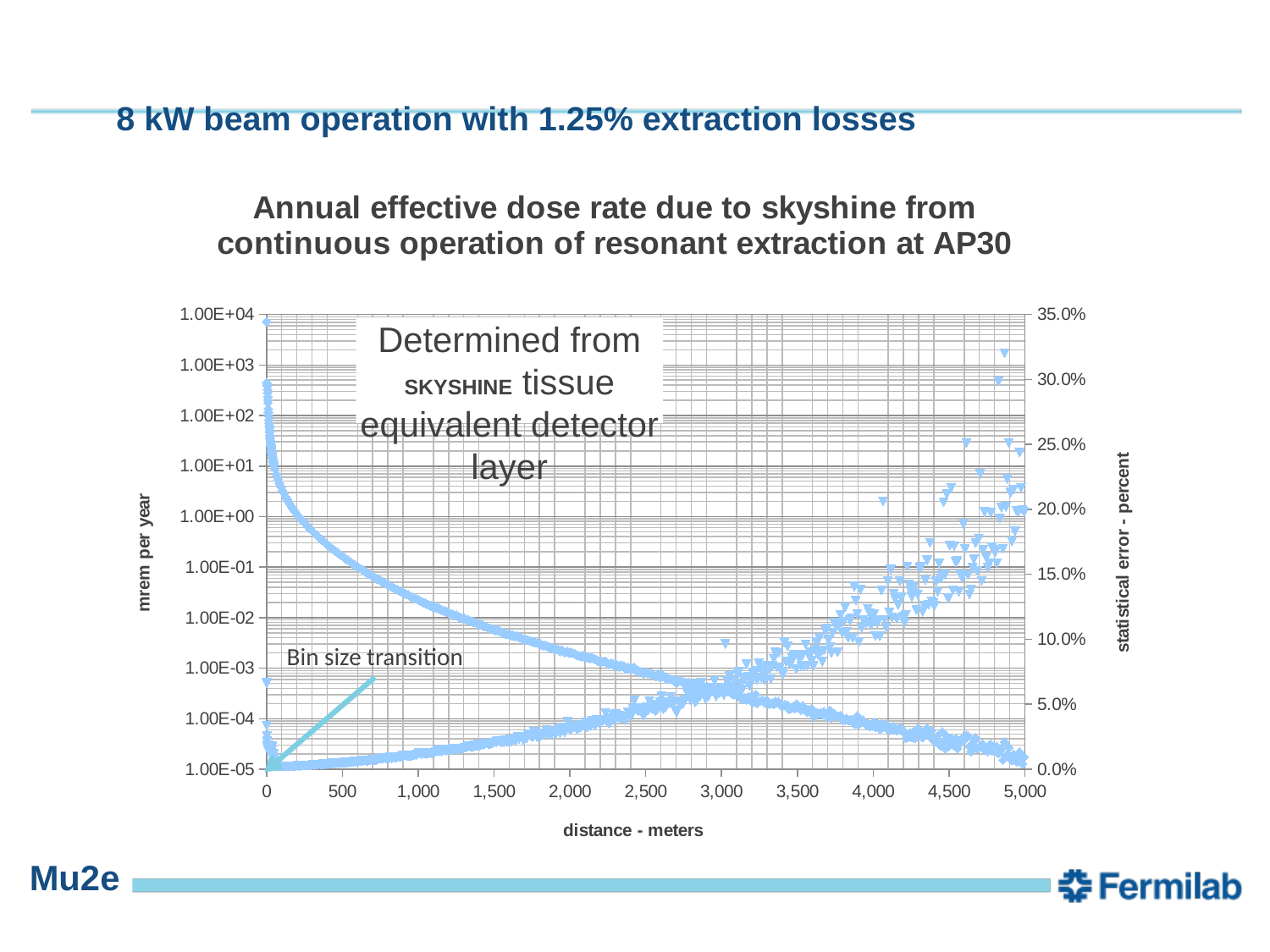
What is the label of the right-hand vertical axis? statistical error - percent Does the dose rate (mrem per year) rise or fall as distance increases? fall Is the dose rate at a distance of 100 meters greater or less than 1.00E+00 mrem per year? greater What kind of chart is shown on the slide? scatter chart Is the dose rate larger at a distance of 500 meters or at 4,000 meters? 500 meters Does the statistical error rise or fall as distance increases? rise Is the dose rate at a distance of 3,000 meters greater or less than 1.00E-03 mrem per year? less Is the dose rate at a distance of 1,000 meters greater or less than 1.00E+00 mrem per year? less What is the title of the chart? Annual effective dose rate due to skyshine from continuous operation of resonant extraction at AP30